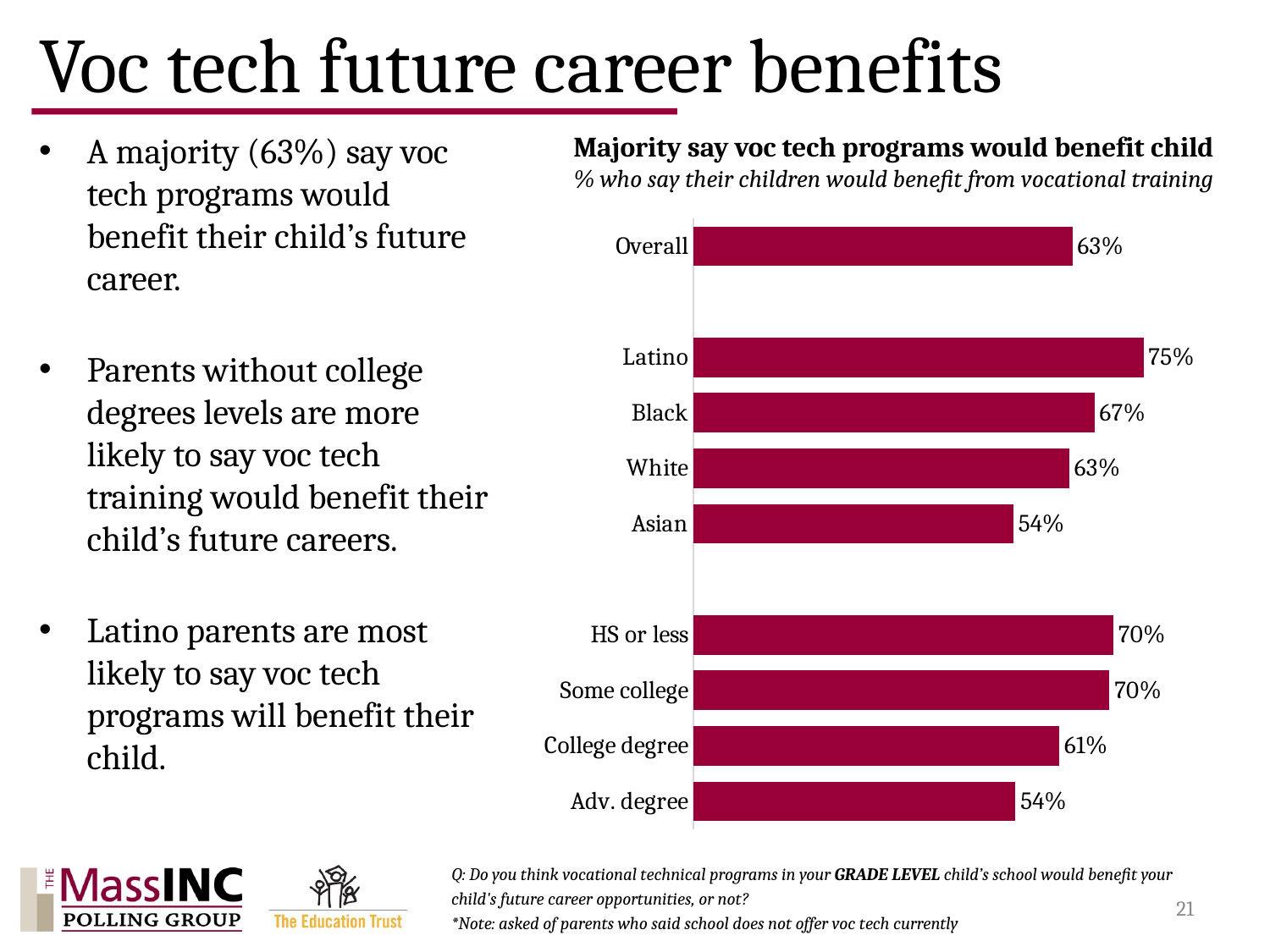
How many categories (bars) are shown in the chart? 9 Which category among the race groups (Latino, Black, White, Asian) has the lowest value? Asian What is the difference between the values for Latino and Asian parents? 21 percentage points What percentage is shown for parents with an Adv. degree? 54% What is the difference between the values for HS or less and College degree? 9 percentage points What is the value shown for the Overall category? 63% What percentage of Latino parents say voc tech programs would benefit their child? 75% Do the values for the education categories rise or fall from HS or less down to Adv. degree? Fall What type of chart is shown on the slide? Bar chart Which category has the highest value in the chart? Latino What is the title of the chart? Majority say voc tech programs would benefit child Which is larger, the value for Black parents or the value for White parents? Black